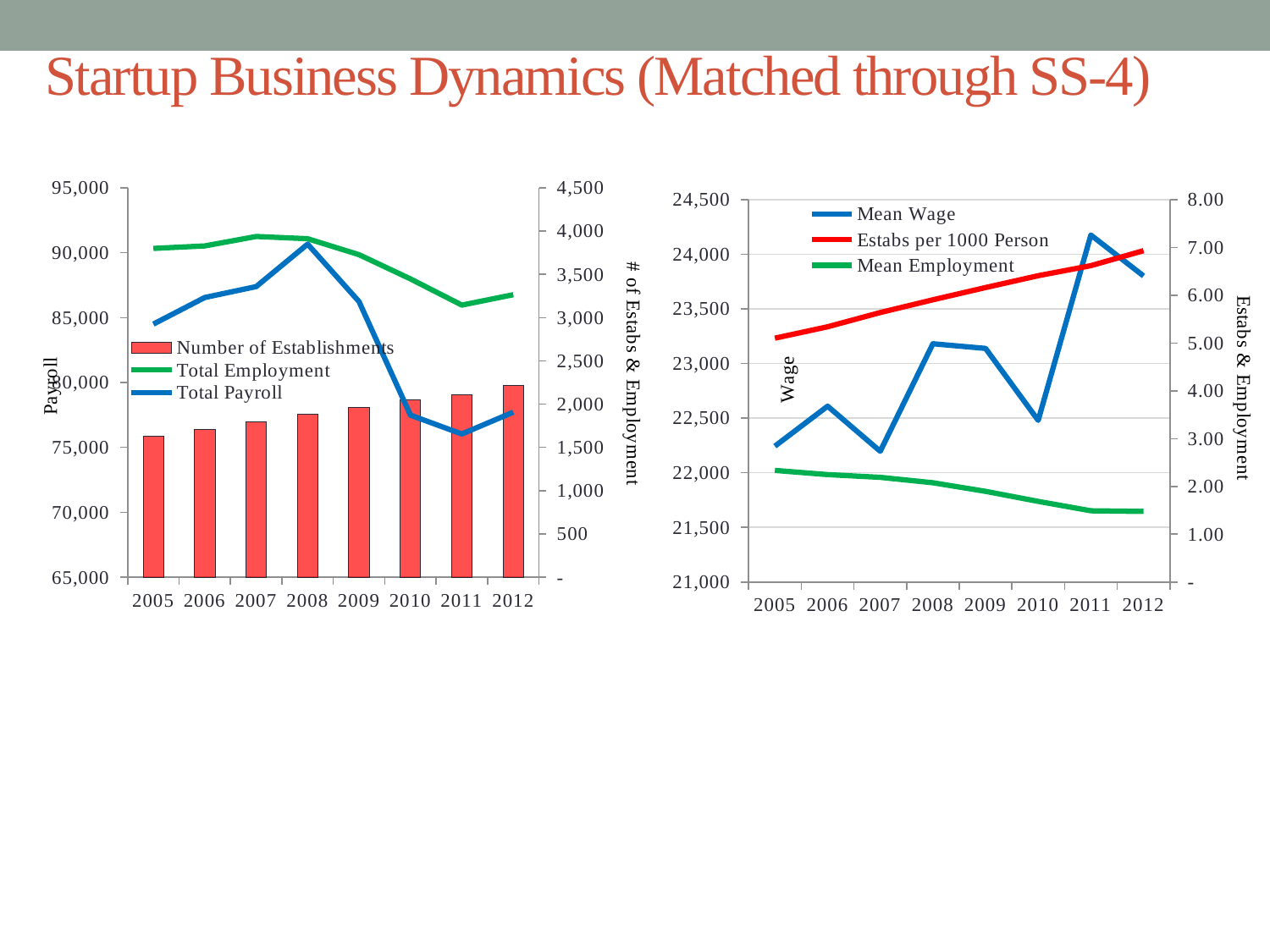
On the left chart, how many years are shown on the x axis? 8 On the left chart, is Total Payroll in 2010 greater or less than 80,000? less On the right chart, in which year is Mean Wage highest? 2011 On the right chart, how many series does the legend list? 3 On the left chart, in which year is Number of Establishments lowest? 2005 What kind of chart is the right chart? Line chart On the right chart, does Mean Employment rise or fall from 2005 to 2012? Fall On the left chart, in which year is Total Payroll highest? 2008 On the left chart, how many series does the legend list? 3 On the right chart, is Estabs per 1000 Person in 2012 greater or less than 6.00? greater On the left chart, which series is drawn as bars? Number of Establishments On the left chart, does Number of Establishments rise or fall from 2005 to 2012? Rise